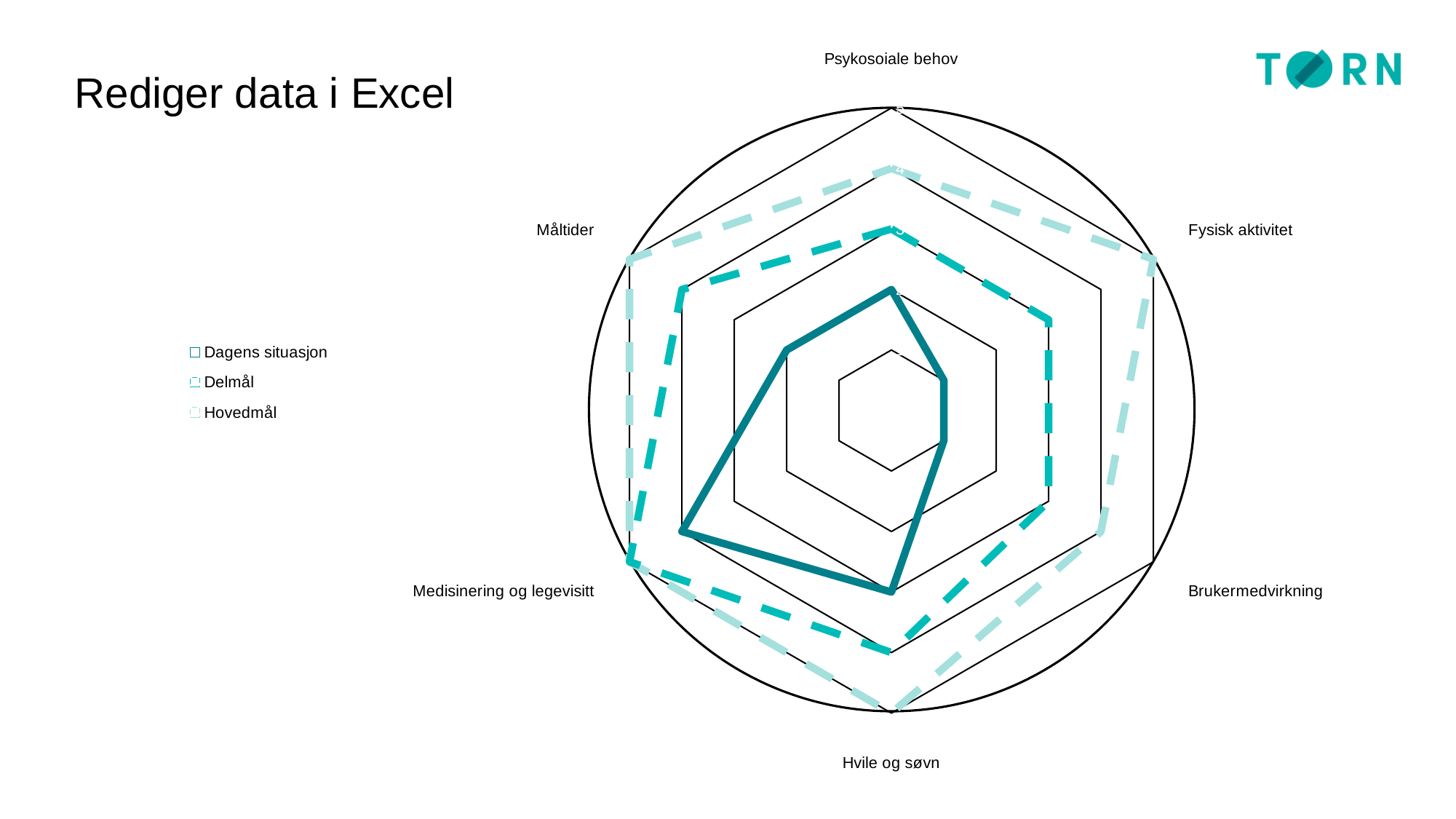
For the Dagens situasjon series, which category has the highest value? Medisinering og legevisitt For Brukermedvirkning, which series has the smallest value? Dagens situasjon For the Dagens situasjon series, which is larger: Medisinering og legevisitt or Måltider? Medisinering og legevisitt For Fysisk aktivitet, which series has the larger value: Hovedmål or Delmål? Hovedmål Which series forms the outermost line on the radar chart? Hovedmål For the Dagens situasjon series, is the value for Fysisk aktivitet larger or smaller than the value for Medisinering og legevisitt? smaller How many categories (axes) does the radar chart have? 6 How many series does the legend list? 3 Which series are listed in the legend? Dagens situasjon, Delmål, Hovedmål What is the title of the slide? Rediger data i Excel What kind of chart is shown on the slide? Radar chart